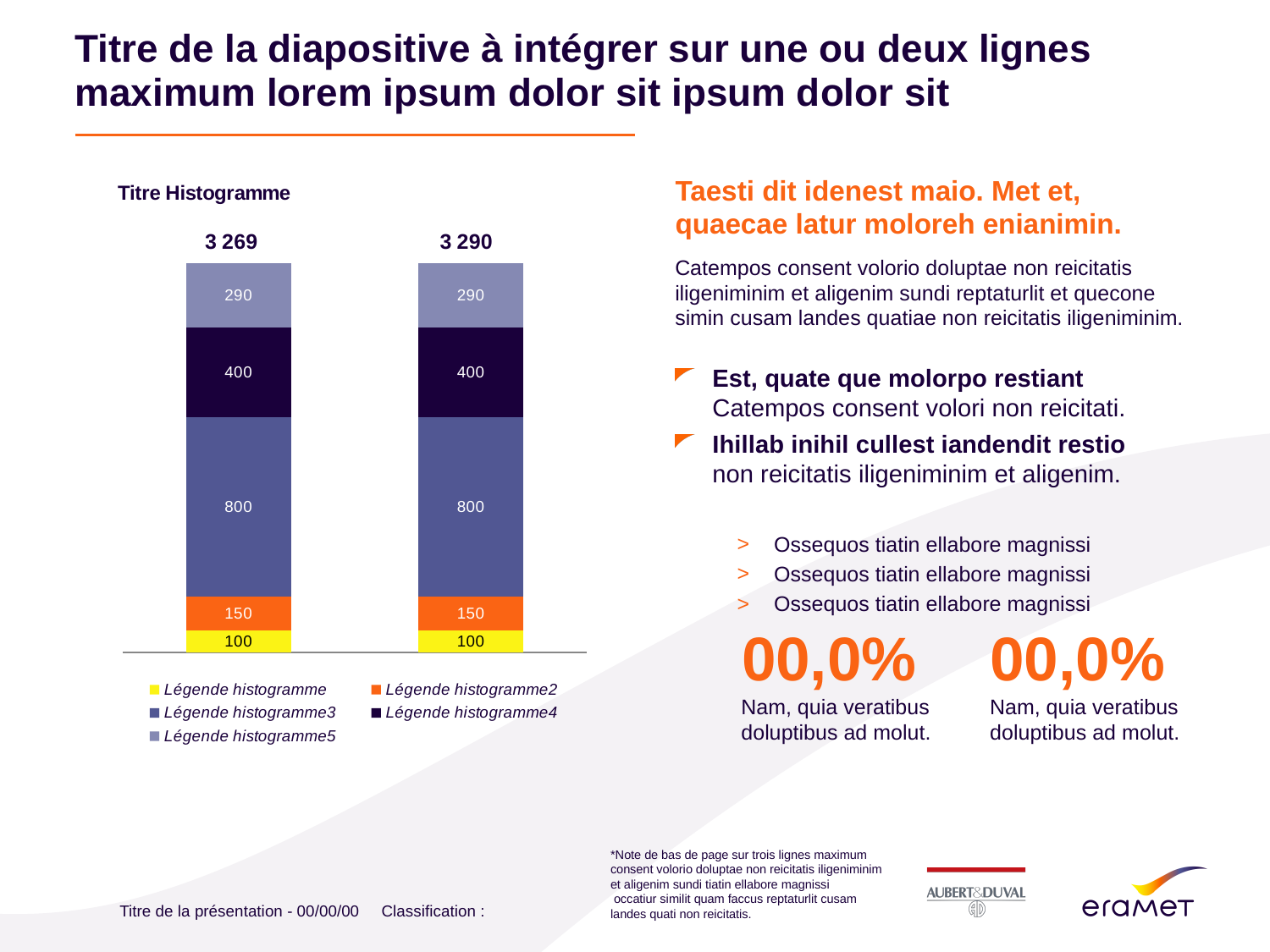
In the "Titre Histogramme" chart, what is the value of the "Légende histogramme" segment in the right bar? 100 In the "Titre Histogramme" chart, what is the value of the "Légende histogramme2" segment in the left bar? 150 In the "Titre Histogramme" chart, which series has the largest segment in the left bar? Légende histogramme3 In the "Titre Histogramme" chart, what is the value of the "Légende histogramme3" segment in the left bar? 800 In the "Titre Histogramme" chart, which bar has the larger value printed above it, the left or the right? Right What value is printed above the right bar of the "Titre Histogramme" chart? 3 290 How many stacked bars are plotted in the "Titre Histogramme" chart? 2 What kind of chart is shown under the title "Titre Histogramme"? Stacked bar chart What value is printed above the left bar of the "Titre Histogramme" chart? 3 269 How many series does the legend of the "Titre Histogramme" chart list? 5 In the "Titre Histogramme" chart, what is the difference between the "Légende histogramme4" segment and the "Légende histogramme5" segment in the right bar? 110 In the "Titre Histogramme" chart, which series has the smallest segment in the right bar? Légende histogramme